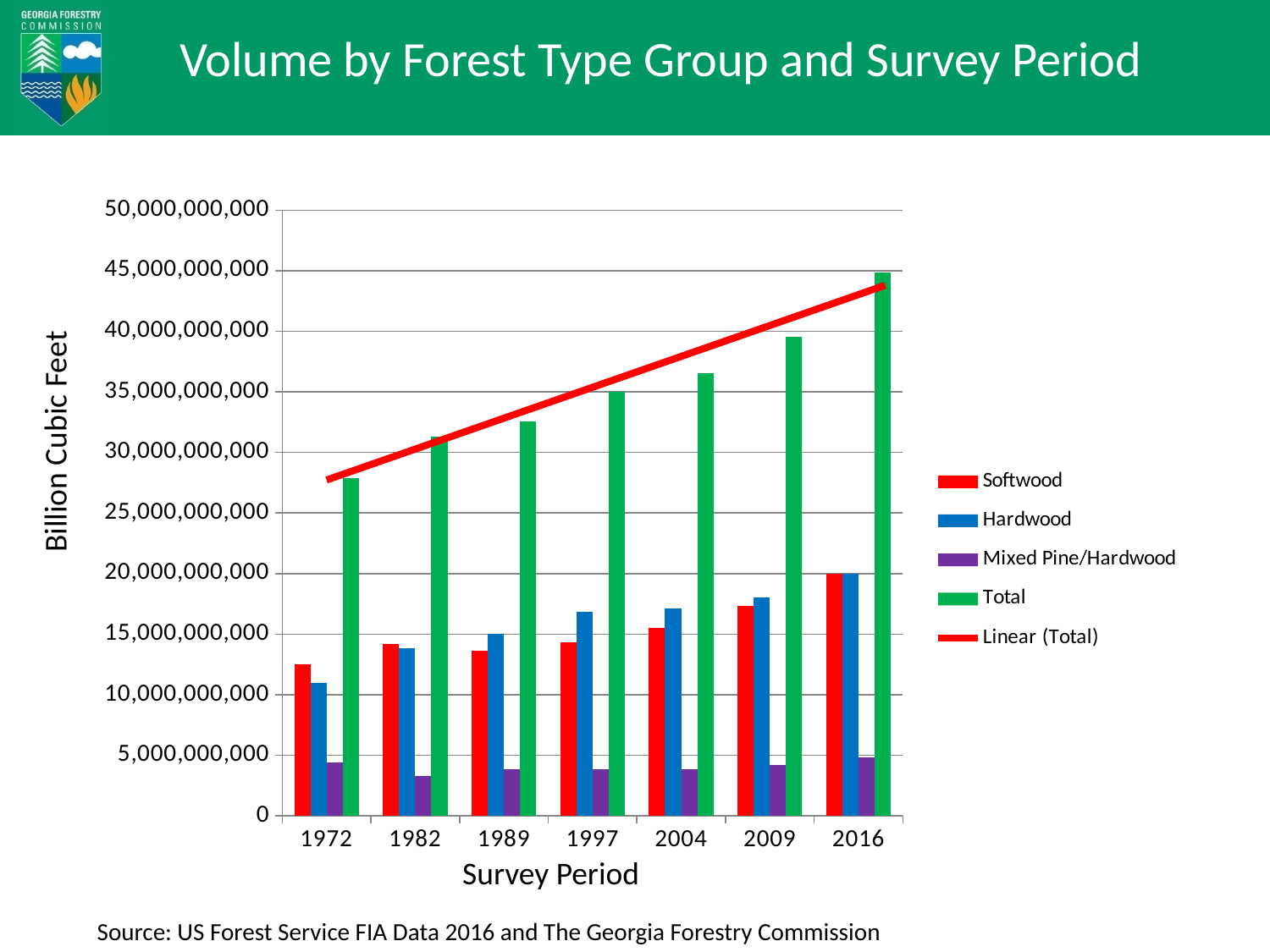
Is the Total value for 1972 greater or less than 30,000,000,000? less How many entries does the legend list? 5 What is the title of the vertical axis? Billion Cubic Feet Does the Total volume rise or fall across the survey periods from 1972 to 2016? rise In which survey period is the Mixed Pine/Hardwood bar lowest? 1982 Is the Total value for 2016 greater or less than 40,000,000,000? greater Is the Mixed Pine/Hardwood value for 1982 greater or less than 5,000,000,000? less What kind of chart is shown on the slide? bar chart In which survey period is the Total bar lowest? 1972 In which survey period is the Total bar highest? 2016 How many survey periods are shown on the x axis? 7 In 1972, which is larger, the Softwood bar or the Hardwood bar? Softwood